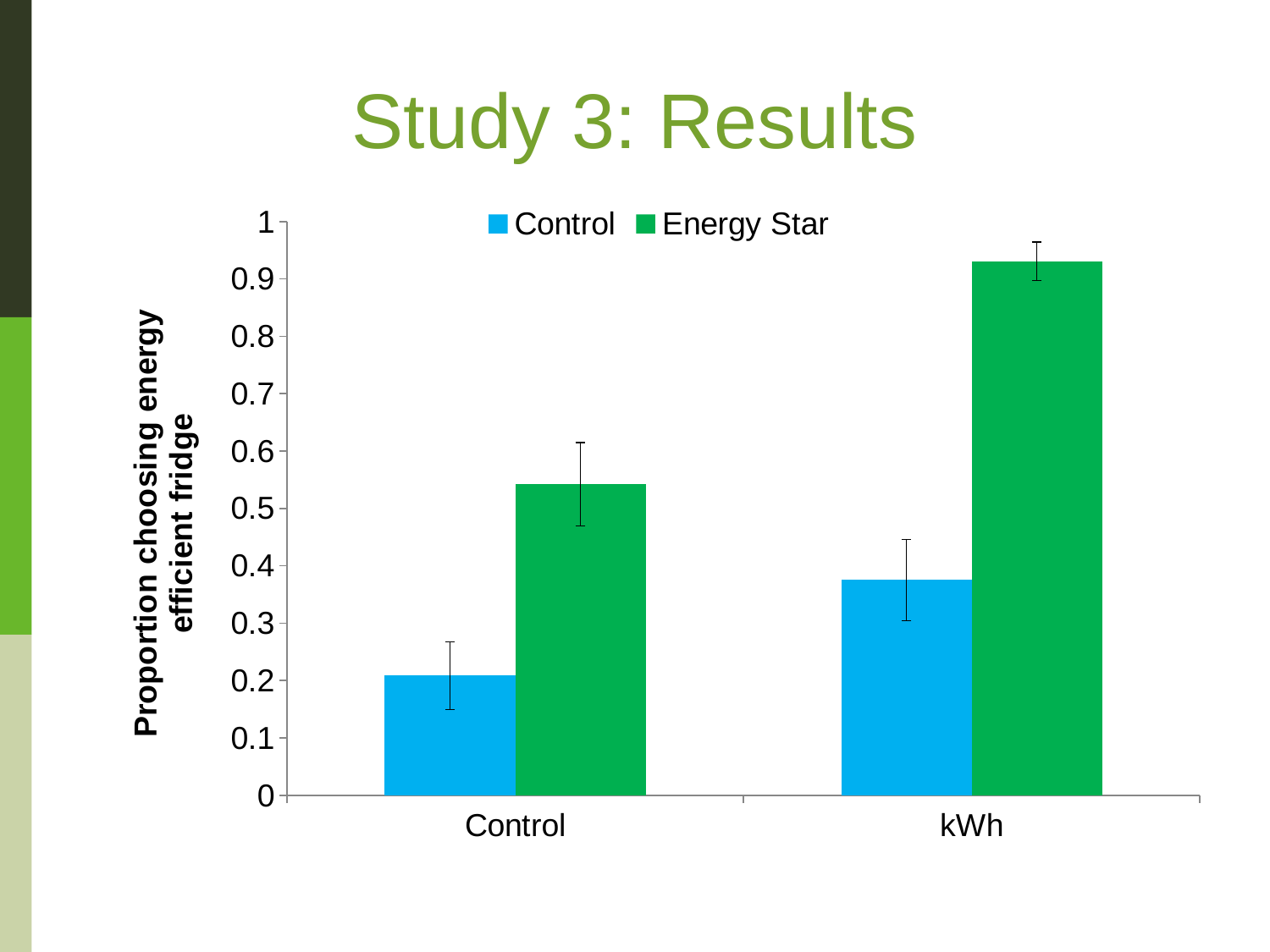
Is the Control value for kWh greater or less than 0.5? less How many series does the legend list? 2 What is the label on the y axis? Proportion choosing energy efficient fridge In the kWh category, which series has the larger value, Control or Energy Star? Energy Star What kind of chart is shown on the slide? bar chart Is the Control value for the Control category greater or less than 0.3? less Which series has the highest bar in the chart? Energy Star How many categories are shown on the x axis? 2 Which is larger: the Energy Star value for Control or the Control value for kWh? Energy Star value for Control Is the Energy Star value for kWh greater or less than 0.9? greater Which category has the lowest Control bar? Control